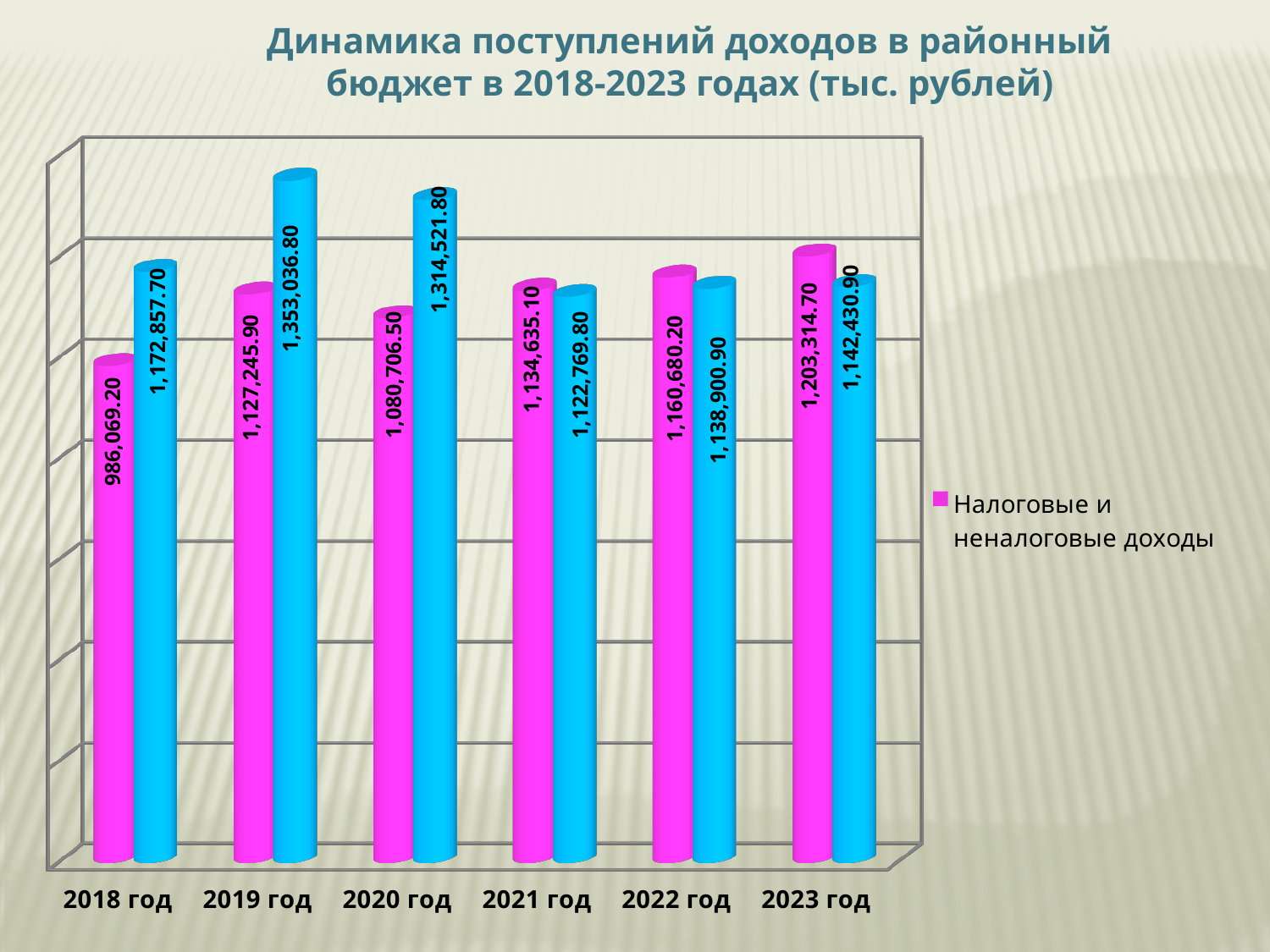
In which year is the value of Налоговые и неналоговые доходы the lowest? 2018 год What is the value of Налоговые и неналоговые доходы for 2018 год? 986,069.20 In which year is the value of Налоговые и неналоговые доходы the highest? 2023 год What value is labelled on the blue bar for 2019 год? 1,353,036.80 What is the difference between the blue bar and the Налоговые и неналоговые доходы bar for 2018 год? 186,788.50 What is the difference between the Налоговые и неналоговые доходы bar and the blue bar for 2023 год? 60,883.80 Do the values of Налоговые и неналоговые доходы rise or fall from 2021 год to 2023 год? Rise How many years are shown on the x axis? 6 What type of chart is shown on the slide? Bar chart In which year does the blue series reach its highest value? 2019 год For 2021 год, which is larger: the Налоговые и неналоговые доходы bar or the blue bar? Налоговые и неналоговые доходы What is the value of Налоговые и неналоговые доходы for 2022 год? 1,160,680.20